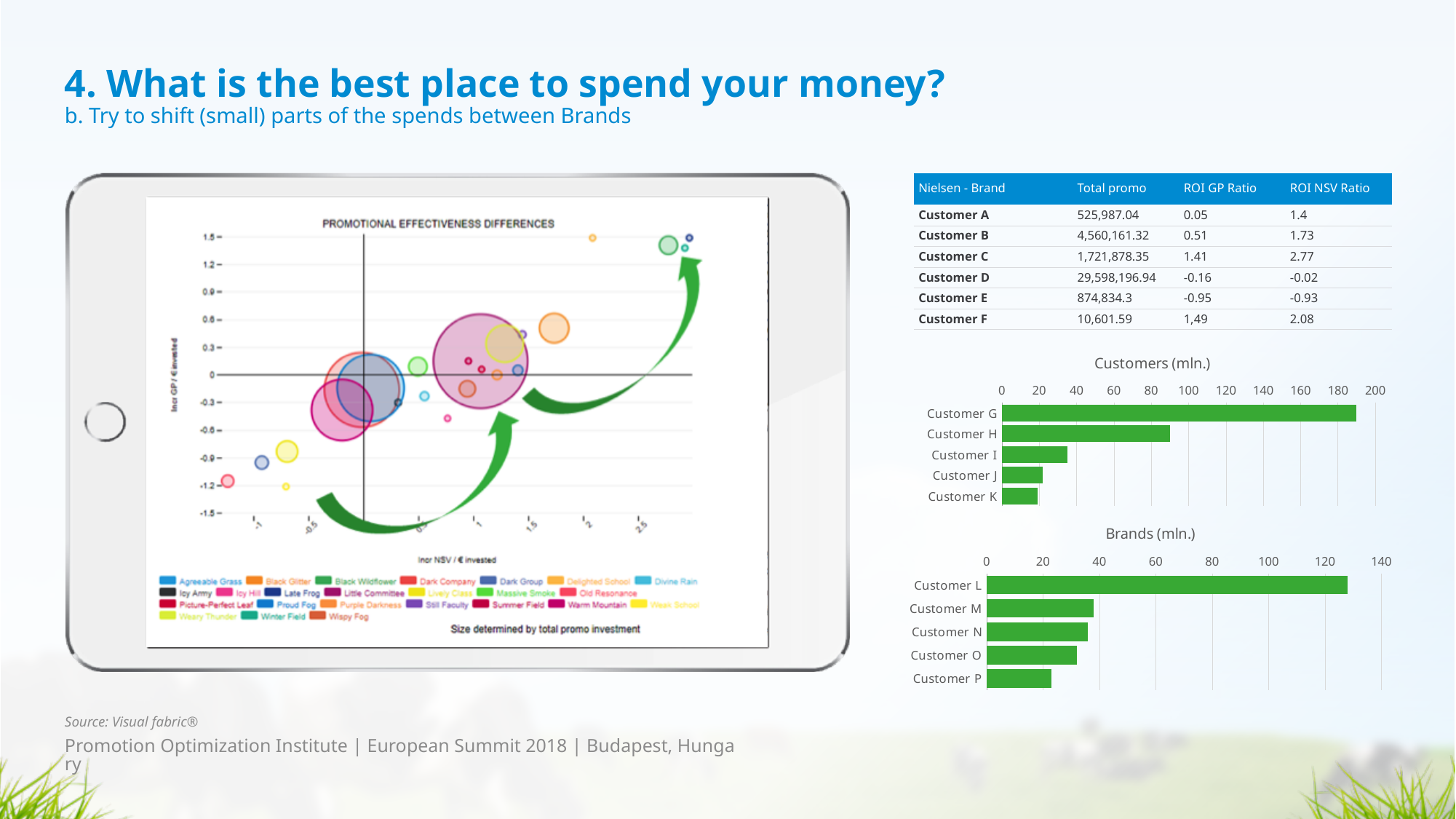
In the "Customers (mln.)" chart, is the value for Customer G greater or less than 180? greater In the "Brands (mln.)" chart, which is larger, the value for Customer M or the value for Customer P? Customer M In the "Customers (mln.)" chart, which customer has the highest value? Customer G What kind of chart is the "Brands (mln.)" chart? bar chart How many categories are shown in the "Customers (mln.)" chart? 5 In the "Brands (mln.)" chart, is the value for Customer L greater or less than 120? greater What kind of chart is the "Customers (mln.)" chart? bar chart In the "Customers (mln.)" chart, is the value for Customer H greater or less than 100? less In the "Customers (mln.)" chart, which is larger, the value for Customer H or the value for Customer I? Customer H What is the title of the chart shown on the tablet on the left of the slide? PROMOTIONAL EFFECTIVENESS DIFFERENCES In the "Brands (mln.)" chart, which customer has the lowest value? Customer P How many categories are shown in the "Brands (mln.)" chart? 5